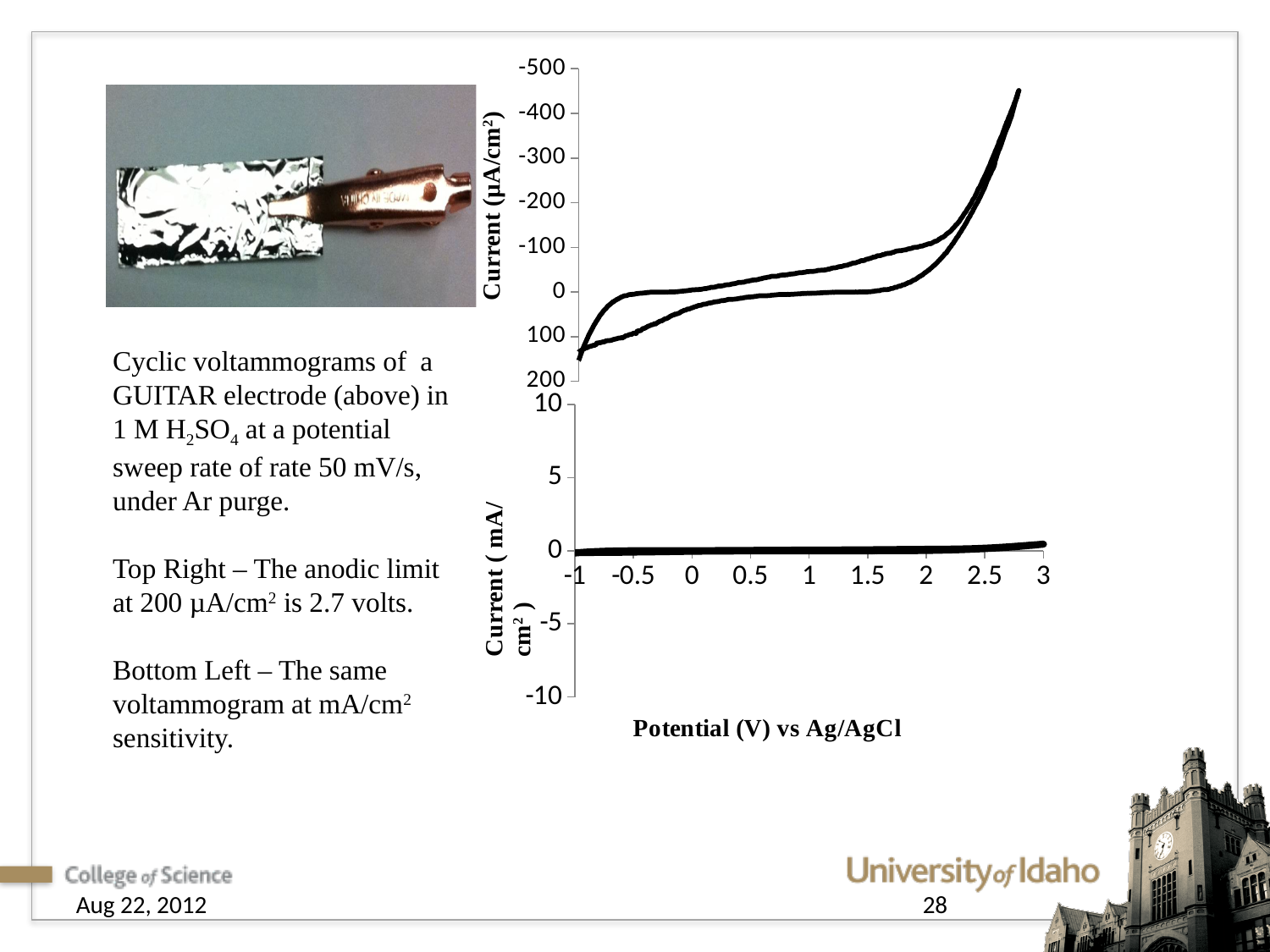
What kind of chart is the top chart on the slide? line chart In the bottom chart, what is the smallest potential shown on the x axis? -1 In the bottom chart, what is the lowest value shown on the y axis? -10 In the bottom chart, what is the largest potential shown on the x axis? 3 What is the x-axis label shown beneath the bottom chart? Potential (V) vs Ag/AgCl What is the y-axis label of the top chart? Current (µA/cm²) In the top chart, is the current at a potential of -1 V greater or less than 0? greater What kind of chart is the bottom chart on the slide? line chart In the top chart, toward the right end of the x axis, does the curve move toward the -500 end or the 200 end of the y axis? -500 end In the bottom chart, is the current at a potential of 0 V greater or less than -5? greater In the bottom chart, is the current at a potential of 1 V greater or less than 5? less In the bottom chart, what is the highest value shown on the y axis? 10